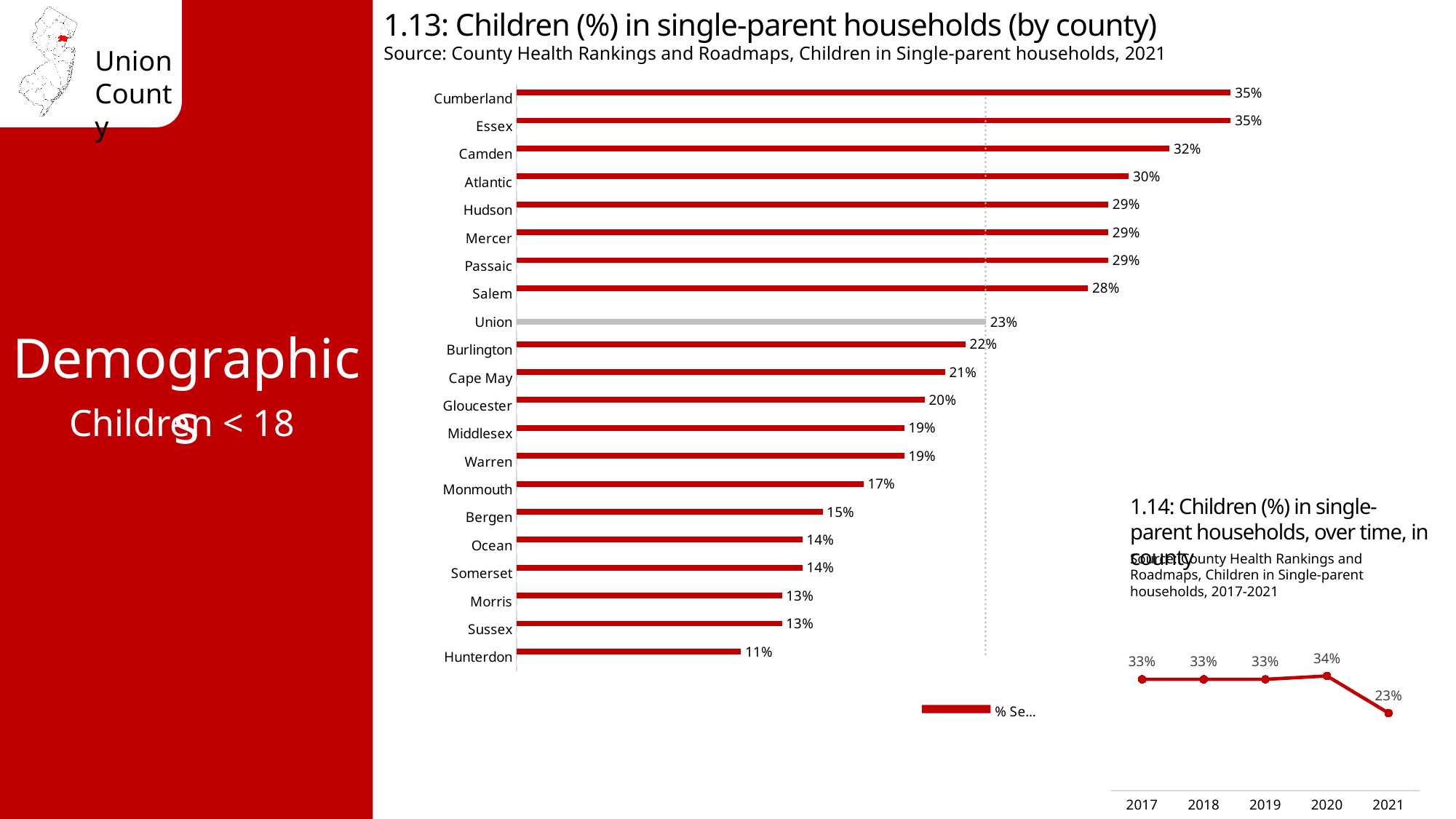
In chart 1.13 (Children (%) in single-parent households by county), what is the value for Union? 23% In chart 1.13 (by county), what is the value for Monmouth? 17% In chart 1.14 (over time, in county), how many years are plotted? 5 In chart 1.14 (over time, in county), what is the difference between 2020 and 2021? 11% In chart 1.14 (over time, in county), what is the value for 2020? 34% What kind of chart is chart 1.14 (over time, in county)? Line chart In chart 1.13 (by county), what is the value for Hunterdon? 11% In chart 1.13 (by county), which county has the lowest value? Hunterdon What kind of chart is chart 1.13 (by county)? Bar chart In chart 1.13 (by county), how many counties are shown? 21 In chart 1.13 (by county), what is the difference between Cumberland and Union? 12% In chart 1.13 (by county), which is larger, the value for Camden or the value for Atlantic? Camden